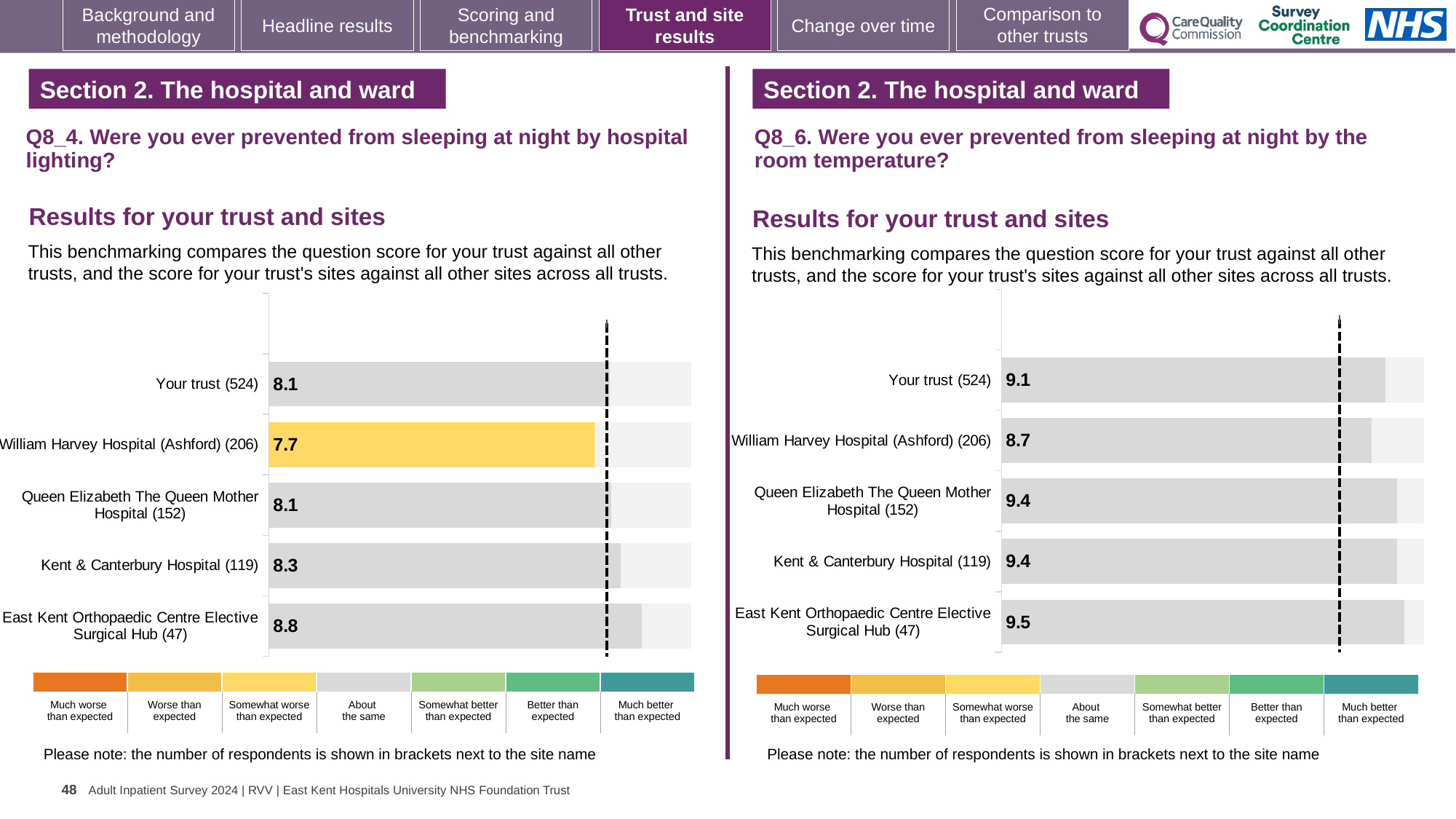
On the Q8_6 chart (room temperature), what is the difference between the scores for Your trust (524) and William Harvey Hospital (Ashford) (206)? 0.4 On the Q8_4 chart (hospital lighting), what is the difference between the scores for East Kent Orthopaedic Centre Elective Surgical Hub (47) and William Harvey Hospital (Ashford) (206)? 1.1 On the Q8_6 chart (room temperature), what is the score for William Harvey Hospital (Ashford) (206)? 8.7 On the Q8_4 chart (hospital lighting), which benchmark category does the yellow colour of the William Harvey Hospital (Ashford) bar represent? Somewhat worse than expected On the Q8_4 chart (hospital lighting), what is the score for Your trust (524)? 8.1 On the Q8_4 chart (hospital lighting), which site has the highest score? East Kent Orthopaedic Centre Elective Surgical Hub (47) What type of chart is used on the left-hand Q8_4 chart? Bar chart On the Q8_6 chart (room temperature), what is the score for East Kent Orthopaedic Centre Elective Surgical Hub (47)? 9.5 On the Q8_4 chart (hospital lighting), which has the higher score: Kent & Canterbury Hospital (119) or Queen Elizabeth The Queen Mother Hospital (152)? Kent & Canterbury Hospital (119) How many bars are shown on the Q8_6 chart (room temperature)? 5 On the Q8_4 chart (hospital lighting), what is the score for William Harvey Hospital (Ashford) (206)? 7.7 On the Q8_6 chart (room temperature), which site has the lowest score? William Harvey Hospital (Ashford) (206)